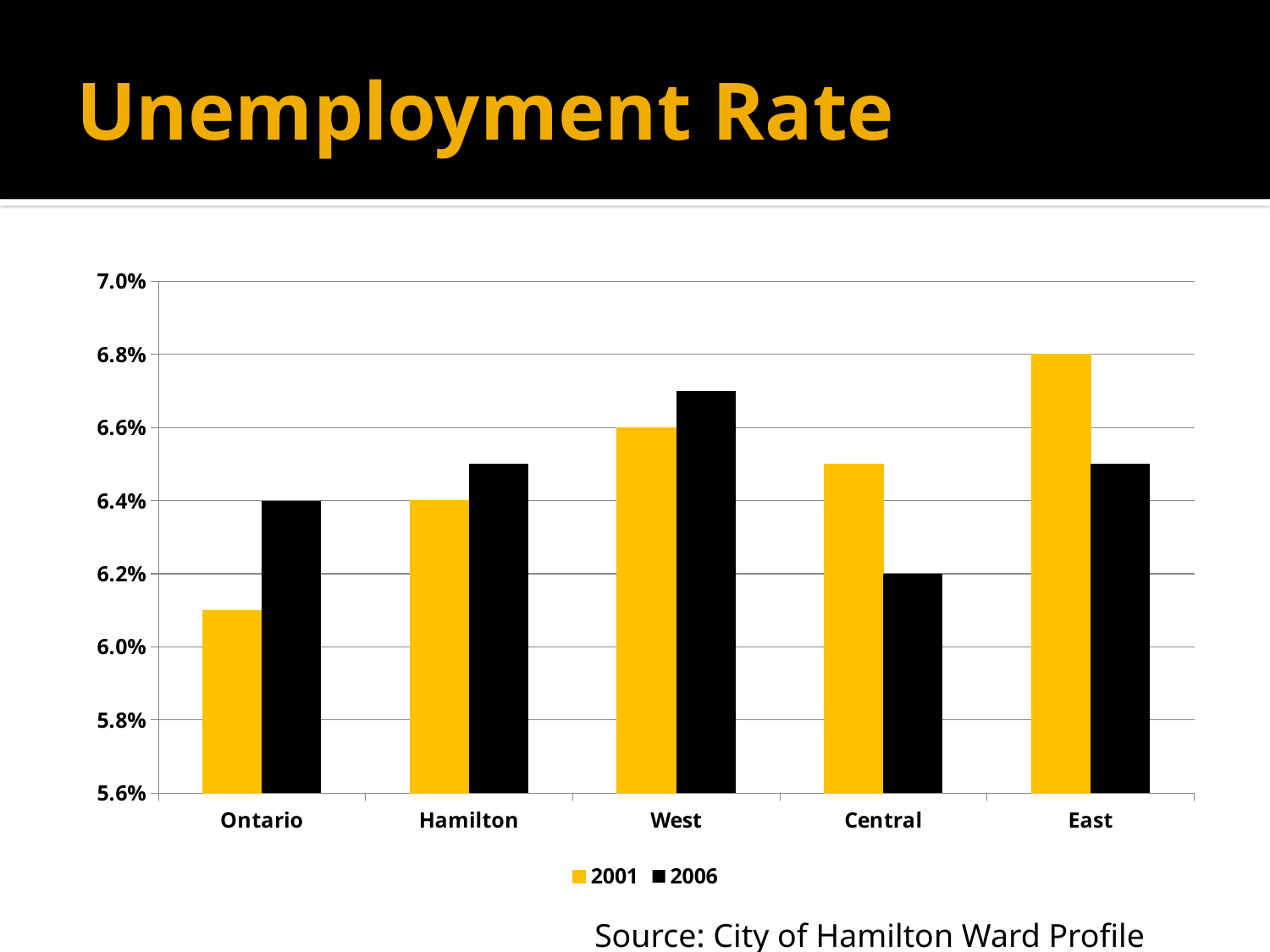
What is the 2001 unemployment rate for East? 6.8% How many categories are shown on the x axis? 5 What type of chart is shown on the slide? bar chart Is the 2001 value for Ontario greater or less than 6.2%? less What is the difference between the 2001 values for East and West? 0.2% Which category has the highest 2001 value? East Which category has the lowest 2006 value? Central For Central, which is larger, the 2001 value or the 2006 value? 2001 What is the 2006 unemployment rate for Central? 6.2% Which category has the highest 2006 value? West What is the 2006 unemployment rate for Ontario? 6.4% How many series does the legend list? 2